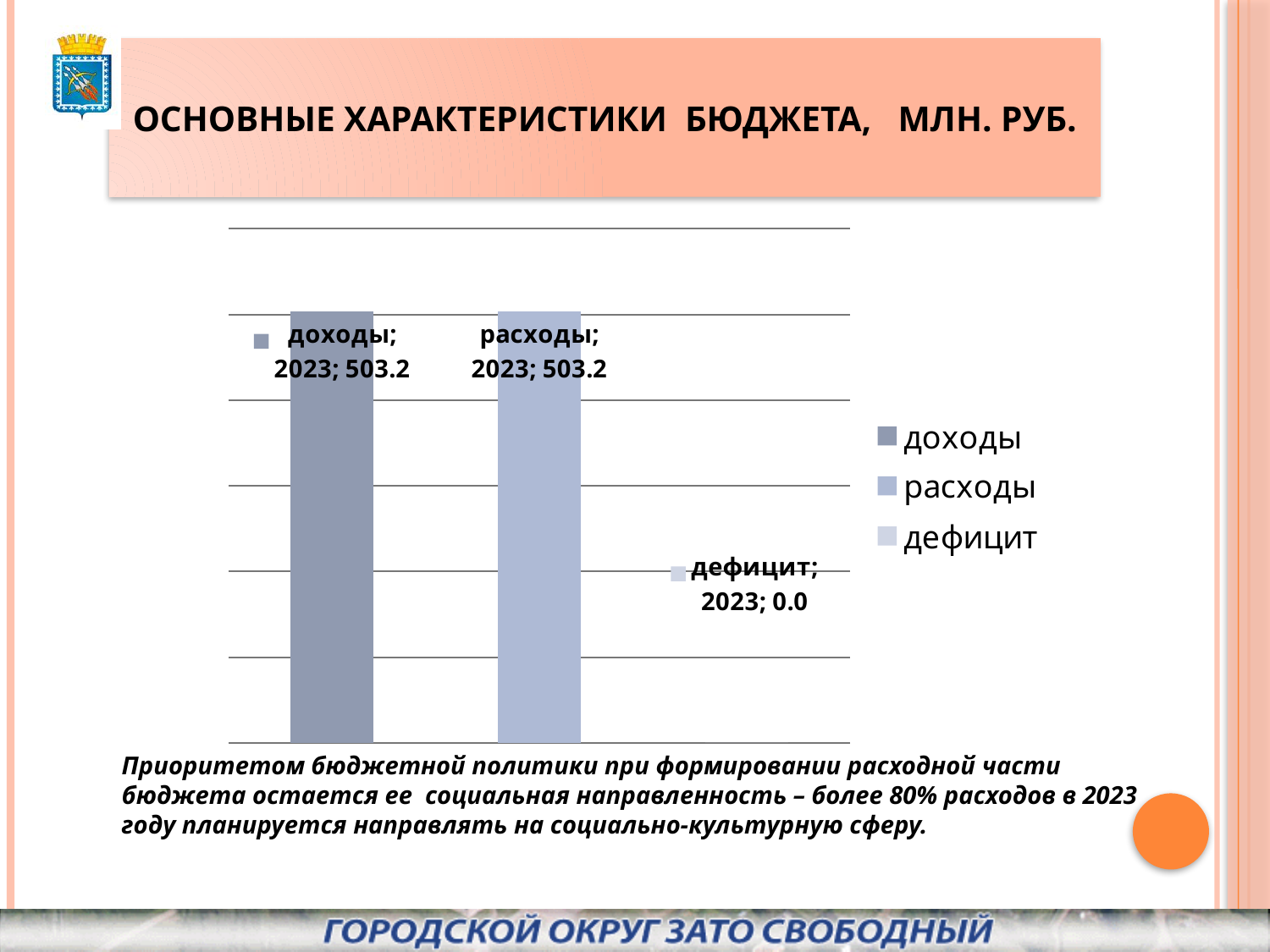
What is the difference between the value for доходы and the value for дефицит? 503.2 Which is larger, the value for доходы or the value for дефицит? доходы What is the difference between the value for доходы and the value for расходы? 0.0 What kind of chart is shown on the slide? bar chart What is the value for дефицит in 2023? 0.0 How many series does the legend list? 3 Which series has the lowest value in the chart? дефицит What is the value for расходы in 2023? 503.2 What is the value for доходы in 2023? 503.2 Which year do the data labels in the chart refer to? 2023 What is the title of the chart on the slide? ОСНОВНЫЕ ХАРАКТЕРИСТИКИ БЮДЖЕТА, МЛН. РУБ. Are the values for доходы and расходы in 2023 equal? yes